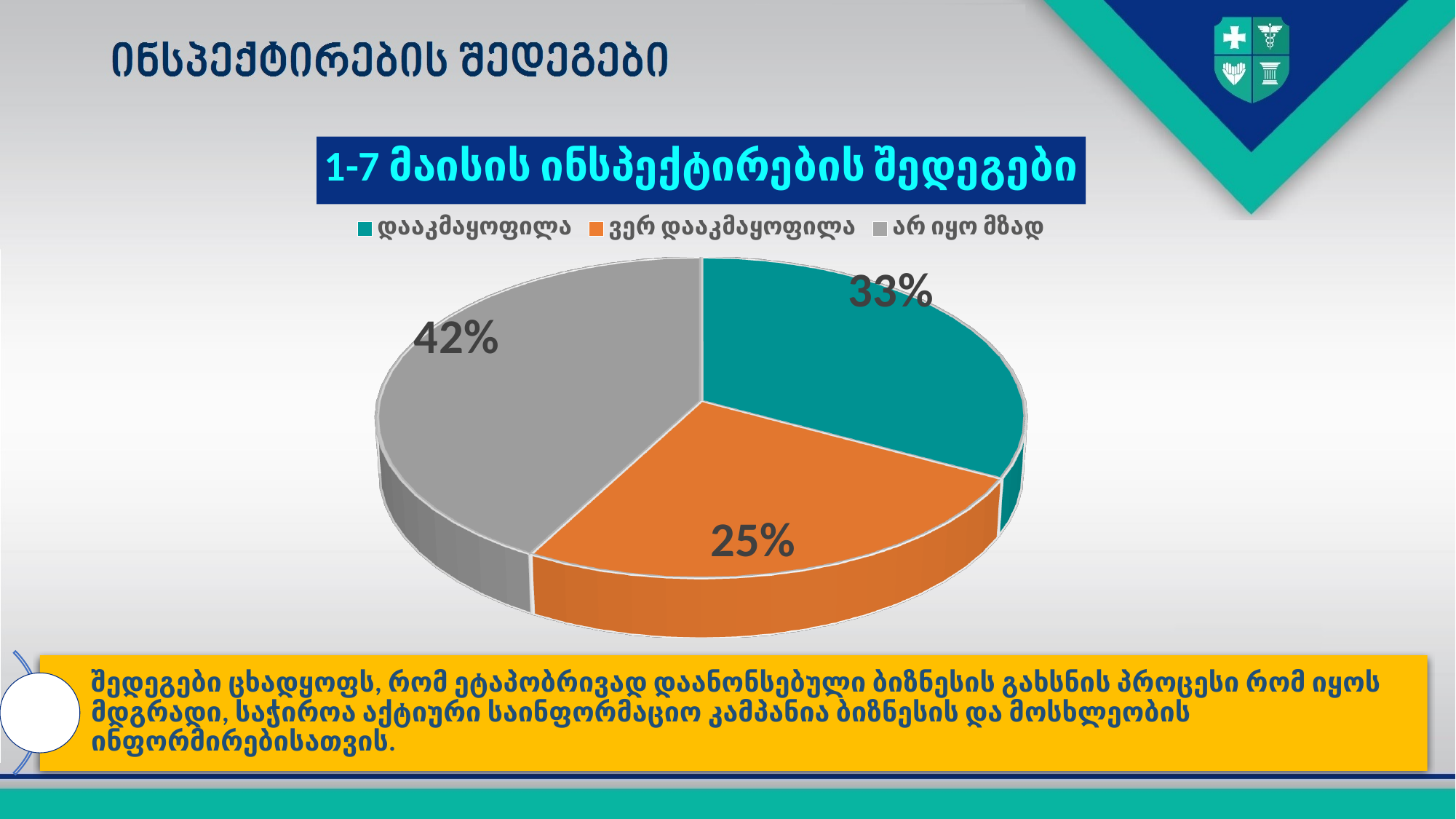
How many slices does the pie chart have? 3 How many entries does the chart legend list? 3 What is the difference in percentage points between არ იყო მზად and დააკმაყოფილა? 9 What is the title of the chart? 1-7 მაისის ინსპექტირების შედეგები What kind of chart is shown on the slide? pie chart Which category has the smallest share of the pie? ვერ დააკმაყოფილა What percentage is shown for ვერ დააკმაყოფილა? 25% Which category has the largest share of the pie? არ იყო მზად Which colour represents ვერ დააკმაყოფილა in the chart? orange What percentage is shown for არ იყო მზად? 42% Which is larger, the share for დააკმაყოფილა or the share for ვერ დააკმაყოფილა? დააკმაყოფილა What percentage is shown for დააკმაყოფილა? 33%